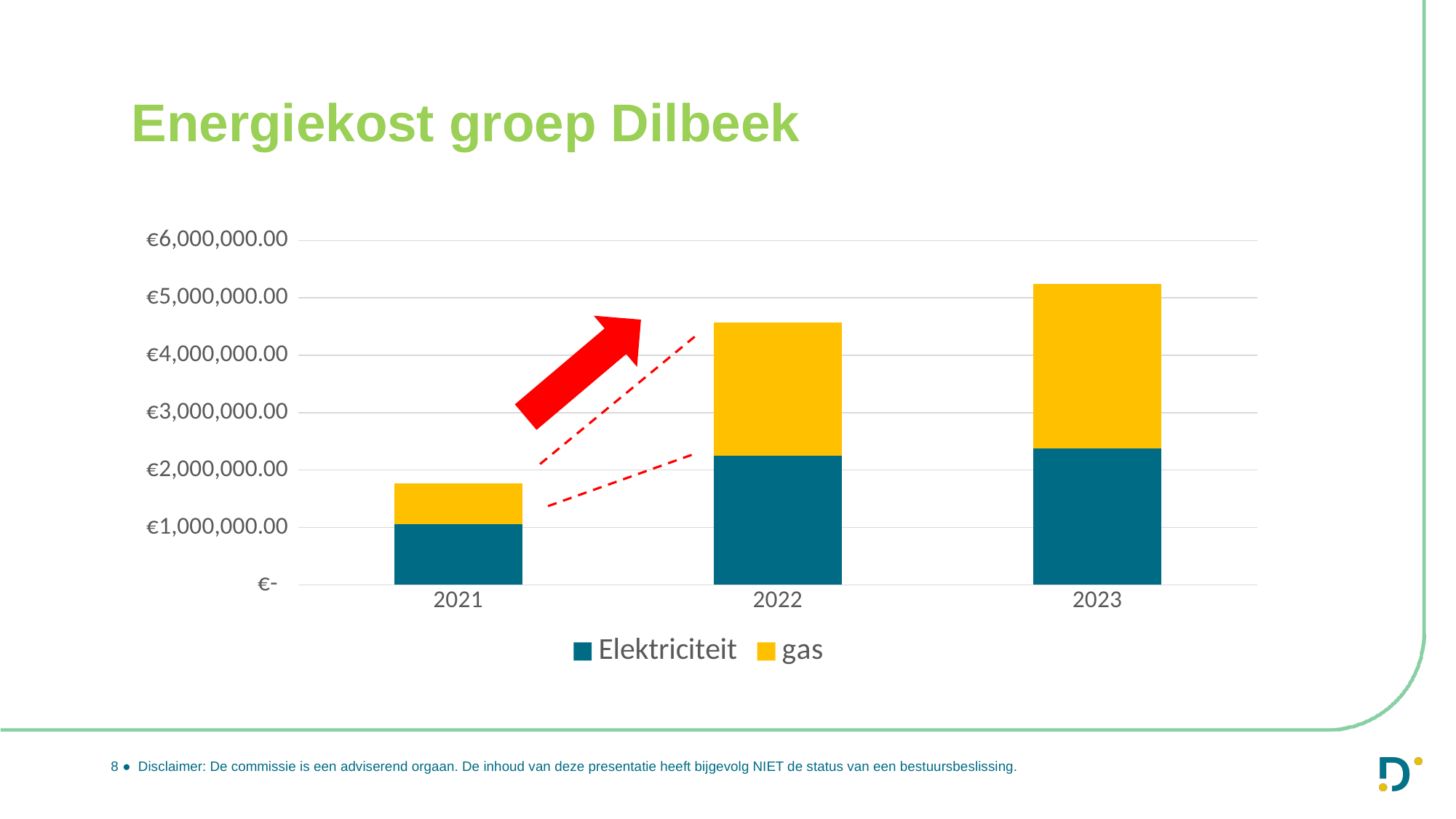
Is the Elektriciteit value for 2022 greater or less than €2,000,000.00? greater Which is larger, the gas cost in 2021 or the gas cost in 2023? 2023 Is the total energy cost for 2021 greater or less than €2,000,000.00? less Is the total energy cost for 2023 greater or less than €5,000,000.00? greater What kind of chart is shown on the slide? Stacked bar chart What is the title of the chart on the slide? Energiekost groep Dilbeek How many series does the legend list? 2 How many years are shown on the x axis? 3 Which colour represents gas in the chart? Yellow Do the total energy costs rise or fall from 2021 to 2023? Rise Which year has the lowest total energy cost? 2021 Which year has the highest total energy cost? 2023